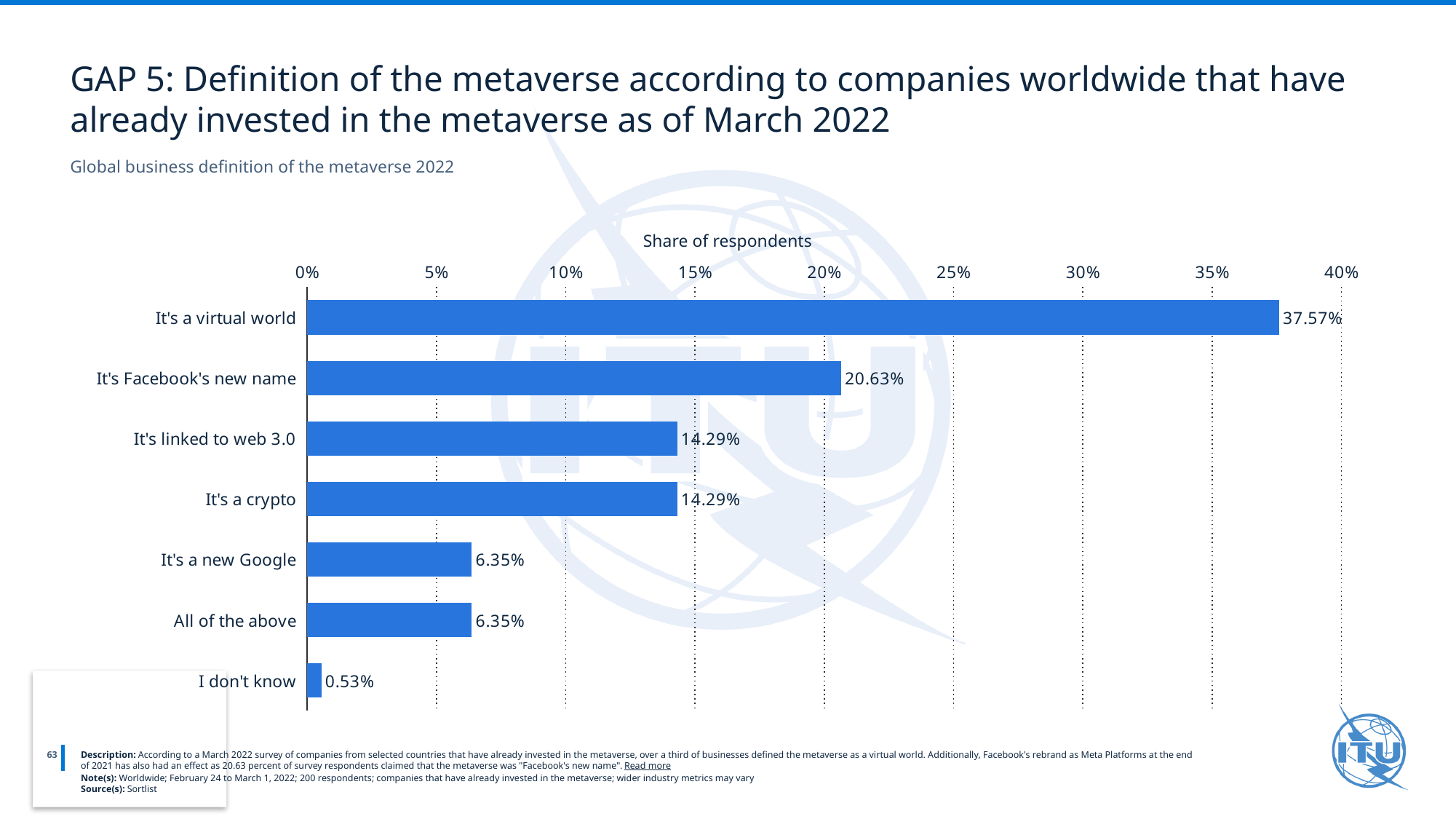
Which is larger: the share for 'It's linked to web 3.0' or 'It's a new Google'? It's linked to web 3.0 What is the value for 'I don't know'? 0.53% What is the value for 'It's a new Google'? 6.35% What share of respondents said the metaverse is Facebook's new name? 20.63% Is the value for 'It's Facebook's new name' greater or less than 20%? greater What is the label of the horizontal axis? Share of respondents What share of respondents said the metaverse is a virtual world? 37.57% What is the difference between the share for 'It's a virtual world' and 'It's Facebook's new name'? 16.94% How many categories are shown in the chart? 7 What kind of chart is shown on the slide? Bar chart Which category has the lowest share of respondents? I don't know Which definition has the highest share of respondents? It's a virtual world